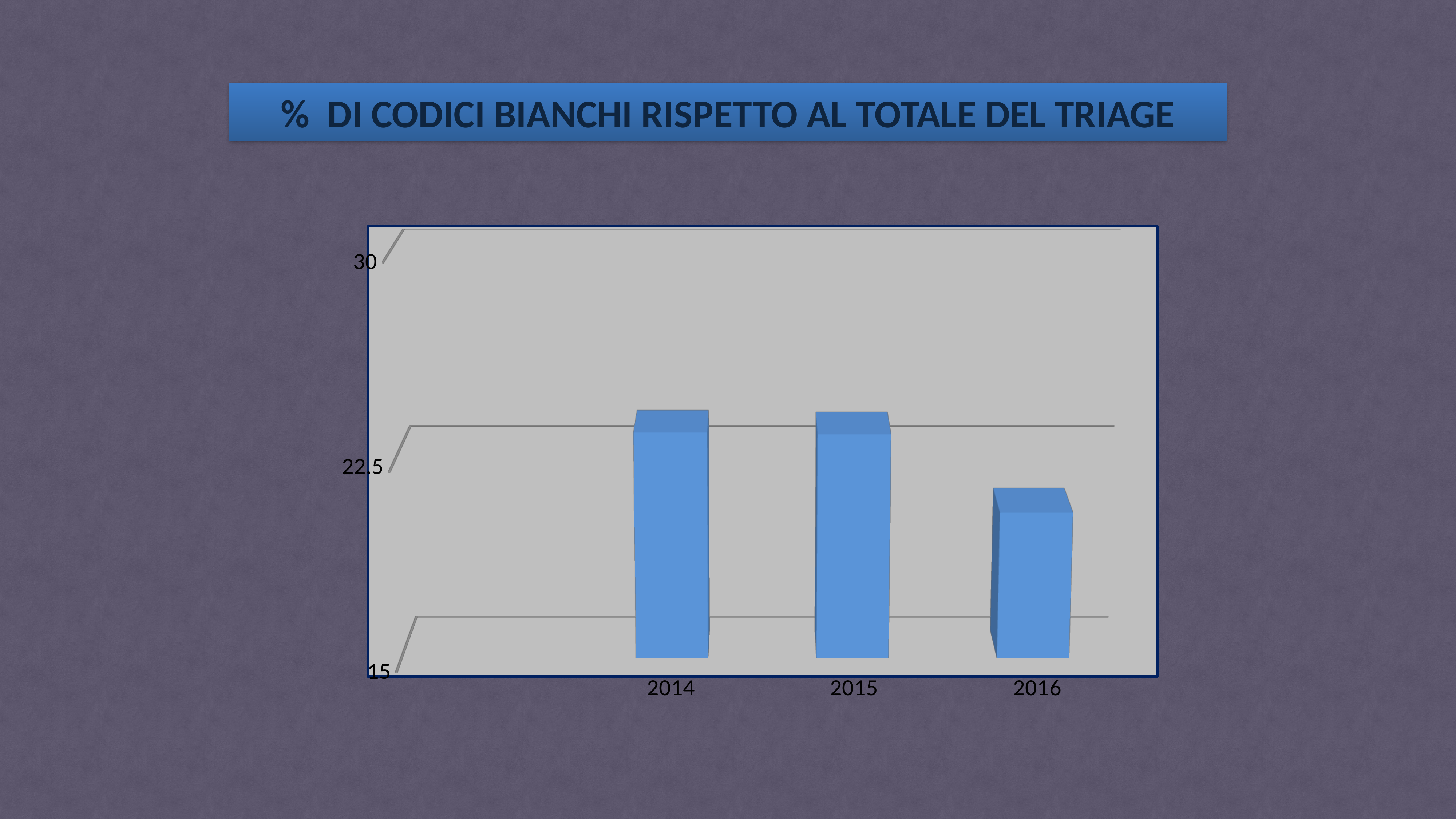
Is the value for 2015 greater or less than 22.5? greater Do the values rise or fall from 2014 to 2016? fall Which is larger, the value for 2015 or the value for 2016? 2015 What is the title of the chart? % DI CODICI BIANCHI RISPETTO AL TOTALE DEL TRIAGE What is the lowest value shown on the y axis of the chart? 15 Which is larger, the value for 2014 or the value for 2016? 2014 What kind of chart is shown on the slide? bar chart Is the value for 2014 greater or less than 22.5? greater Is the value for 2014 greater or less than 30? less How many years are shown on the x axis of the chart? 3 Which year has the lowest value in the chart? 2016